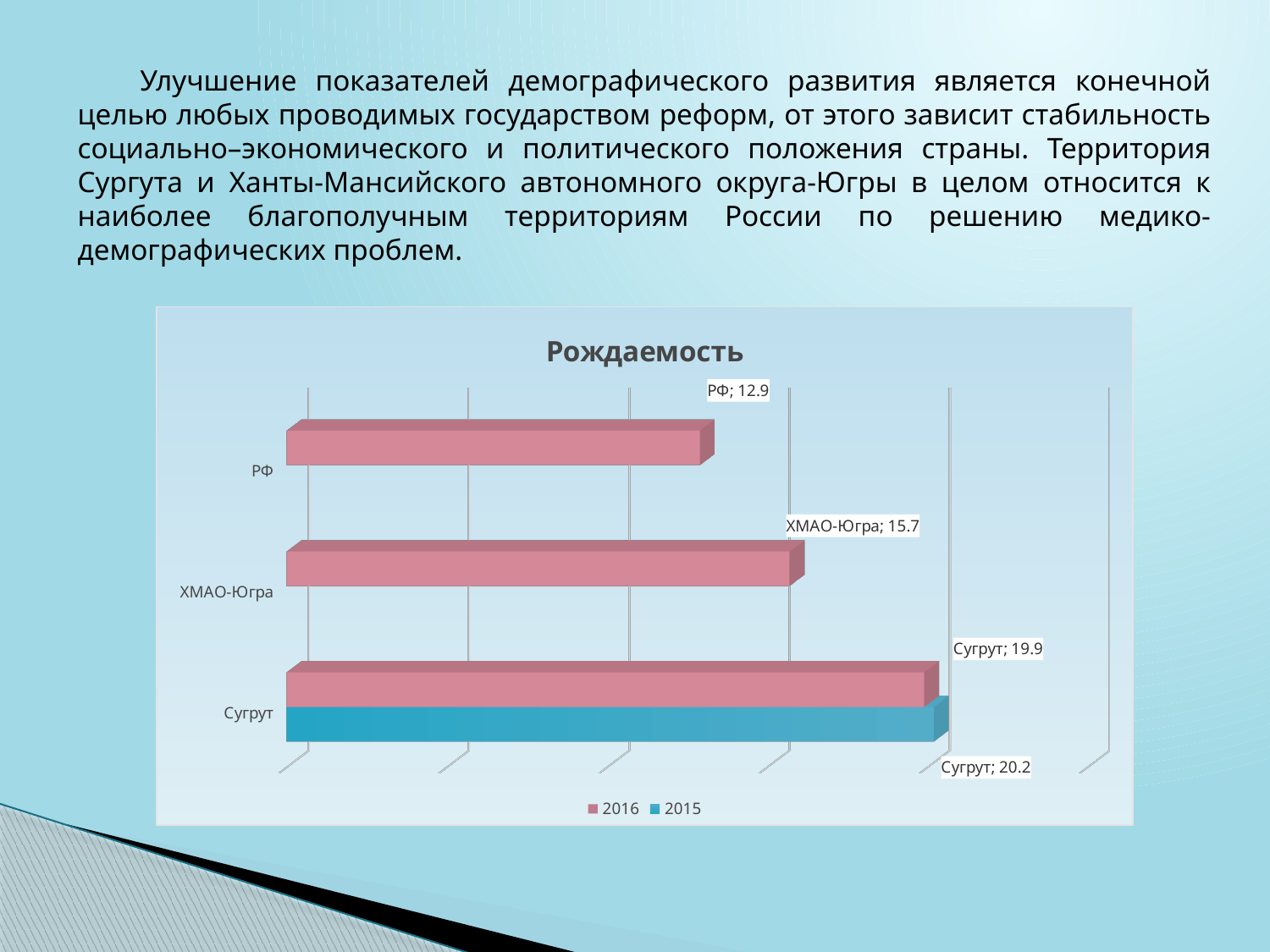
What is the title of the chart? Рождаемость What is the difference between the 2016 values for Сугрут and РФ? 7 What type of chart is shown on the slide? bar chart Which category has the highest 2016 value? Сугрут How many series does the legend list? 2 What is the 2016 value for ХМАО-Югра? 15.7 Which category has the lowest 2016 value? РФ What is the 2016 value for РФ? 12.9 How many categories are shown on the chart? 3 What is the 2016 value for Сугрут? 19.9 Which is larger for Сугрут: the 2015 value or the 2016 value? 2015 What is the 2015 value for Сугрут? 20.2